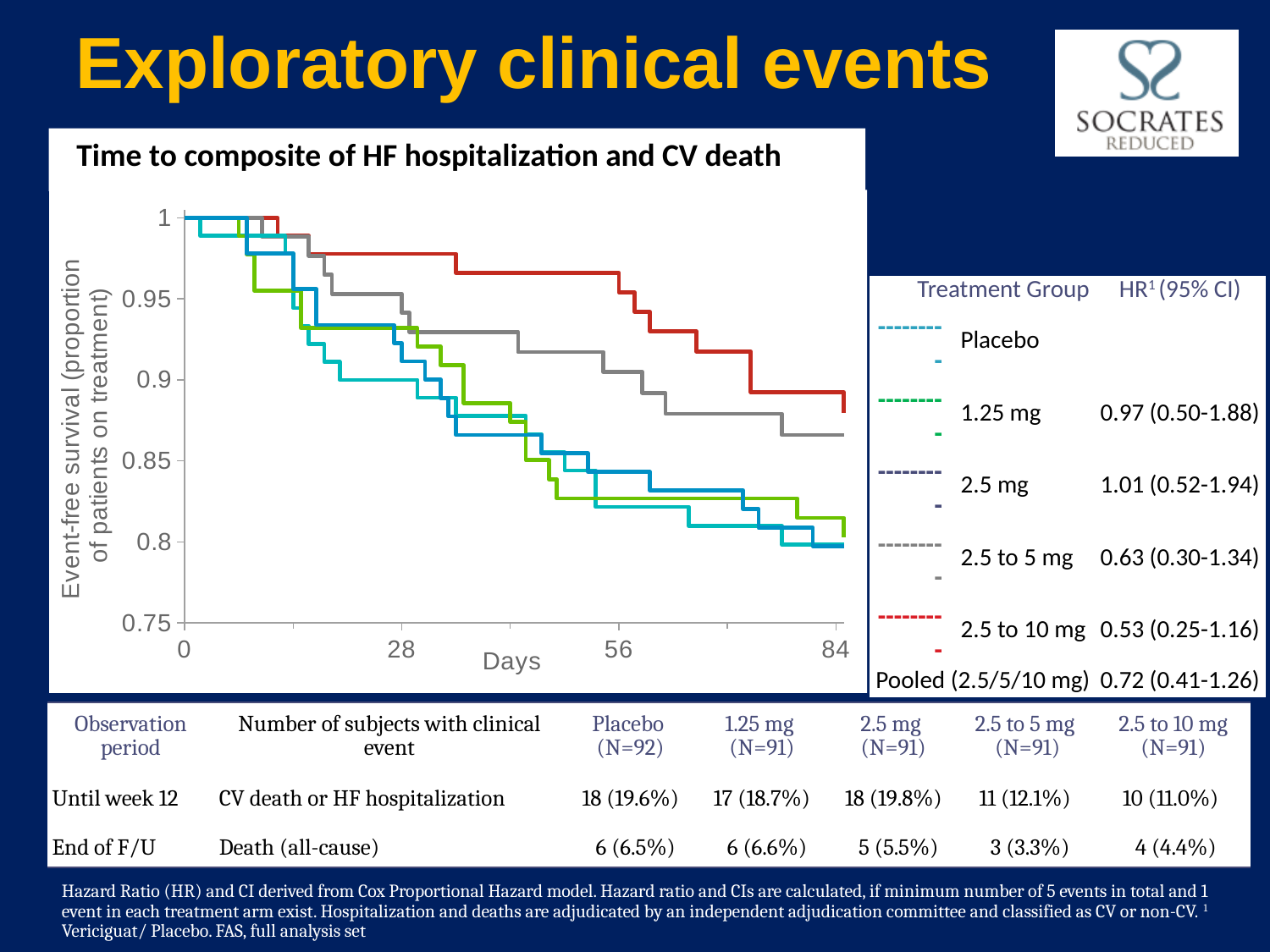
Is the event-free survival for the 2.5 to 10 mg group at day 28 greater or less than 0.95? greater Which treatment group has the highest event-free survival at day 84? 2.5 to 10 mg Do the event-free survival curves rise or fall as days increase? Fall Which treatment group is drawn in red on the survival chart? 2.5 to 10 mg How many treatment groups are listed in the chart legend? 5 What is the HR (95% CI) shown in the legend for the pooled (2.5/5/10 mg) group? 0.72 (0.41-1.26) Is the event-free survival for the 2.5 to 10 mg group at day 84 greater or less than 0.85? greater Is the event-free survival for the 1.25 mg group at day 84 greater or less than 0.85? less What is the HR (95% CI) shown in the legend for the 2.5 to 10 mg group? 0.53 (0.25-1.16) What kind of chart is shown under the title 'Time to composite of HF hospitalization and CV death'? Line chart (Kaplan-Meier survival curve) What is the label on the x axis of the survival chart? Days At day 84, is the event-free survival higher for the 2.5 to 5 mg group or the Placebo group? 2.5 to 5 mg